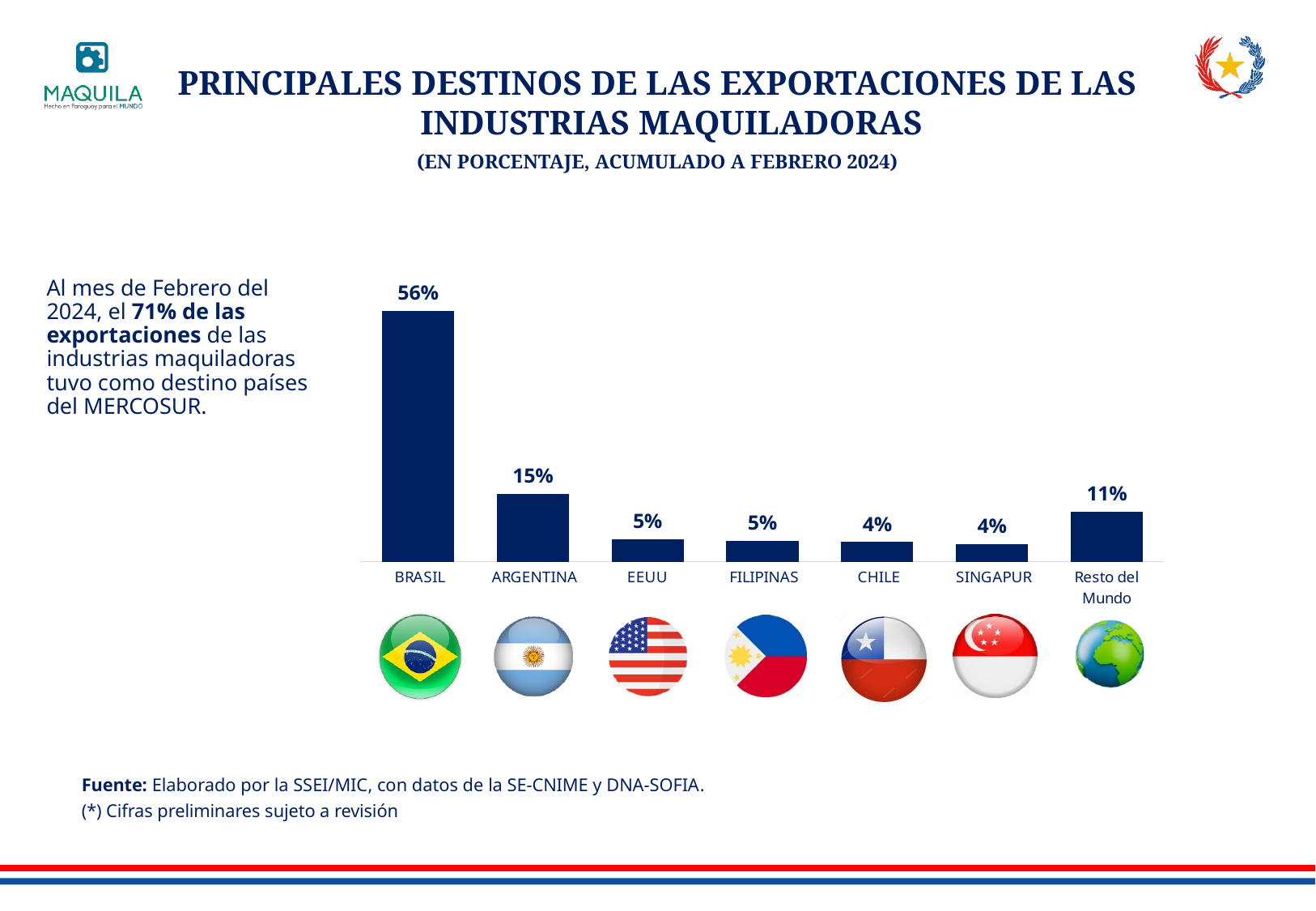
What is the export share for BRASIL? 56% What is the difference between the export shares of BRASIL and ARGENTINA? 41% How many destination categories are shown in the chart? 7 Which has a larger export share, EEUU or SINGAPUR? EEUU What is the combined export share of BRASIL and ARGENTINA? 71% What is the export share for ARGENTINA? 15% Which has a larger export share, Resto del Mundo or FILIPINAS? Resto del Mundo What is the export share for Resto del Mundo? 11% What type of chart is shown on the slide? Bar chart What is the export share for CHILE? 4% What is the difference between the export shares of ARGENTINA and Resto del Mundo? 4% Which destination has the highest export share? BRASIL